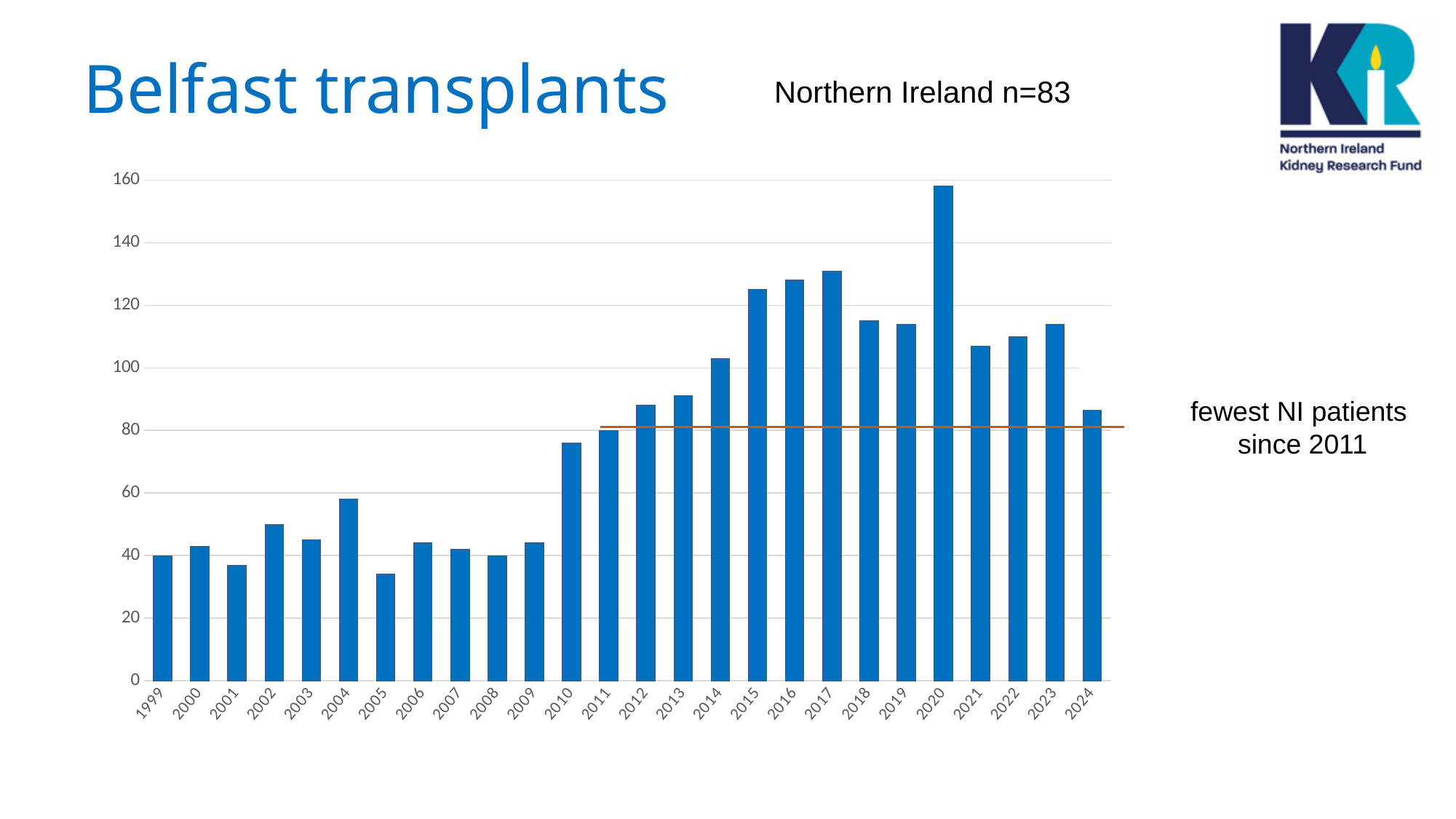
What is the title of the slide containing the chart? Belfast transplants Which year has the larger value, 2004 or 2010? 2010 Is the value for 2024 greater or less than 100? less What kind of chart is shown on the slide? bar chart Do the values generally rise or fall from 2009 to 2017? rise How many years are shown on the x axis of the chart? 26 Which year has the larger value, 2023 or 2024? 2023 Is the value for 2017 greater or less than 120? greater Which year has the lowest number of Belfast transplants? 2005 Is the value for 2020 greater or less than 140? greater Which year has the highest number of Belfast transplants? 2020